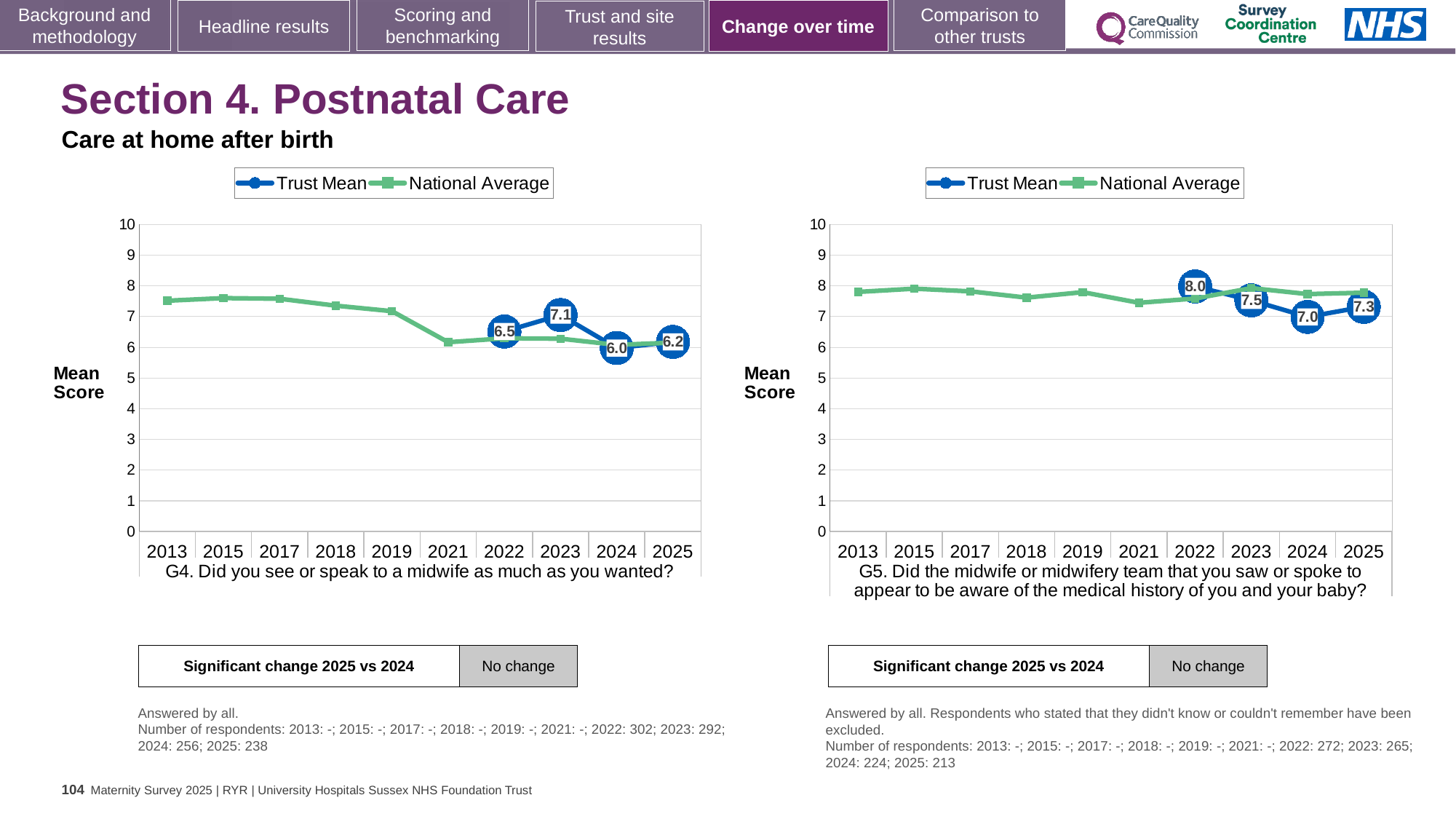
In the G5 chart (right), is the Trust Mean for 2023 larger or smaller than the Trust Mean for 2025? larger In the G4 chart (left), what is the Trust Mean for 2023? 7.1 In the G5 chart (right), what is the difference between the Trust Mean in 2022 and in 2024? 1.0 In the G4 chart (left), which year has the lowest labelled Trust Mean? 2024 How many series does the legend of the G4 chart (left) list? 2 In the G4 chart (left), what is the Trust Mean for 2025? 6.2 In the G4 chart (left), is the National Average for 2013 greater or less than 7? greater What type of chart is the G5 chart (right)? Line chart In the G5 chart (right), which year has the highest labelled Trust Mean? 2022 In the G5 chart (right), what is the Trust Mean for 2024? 7.0 In the G4 chart (left), what is the difference between the Trust Mean in 2023 and in 2024? 1.1 In the G5 chart (right), what is the Trust Mean for 2022? 8.0